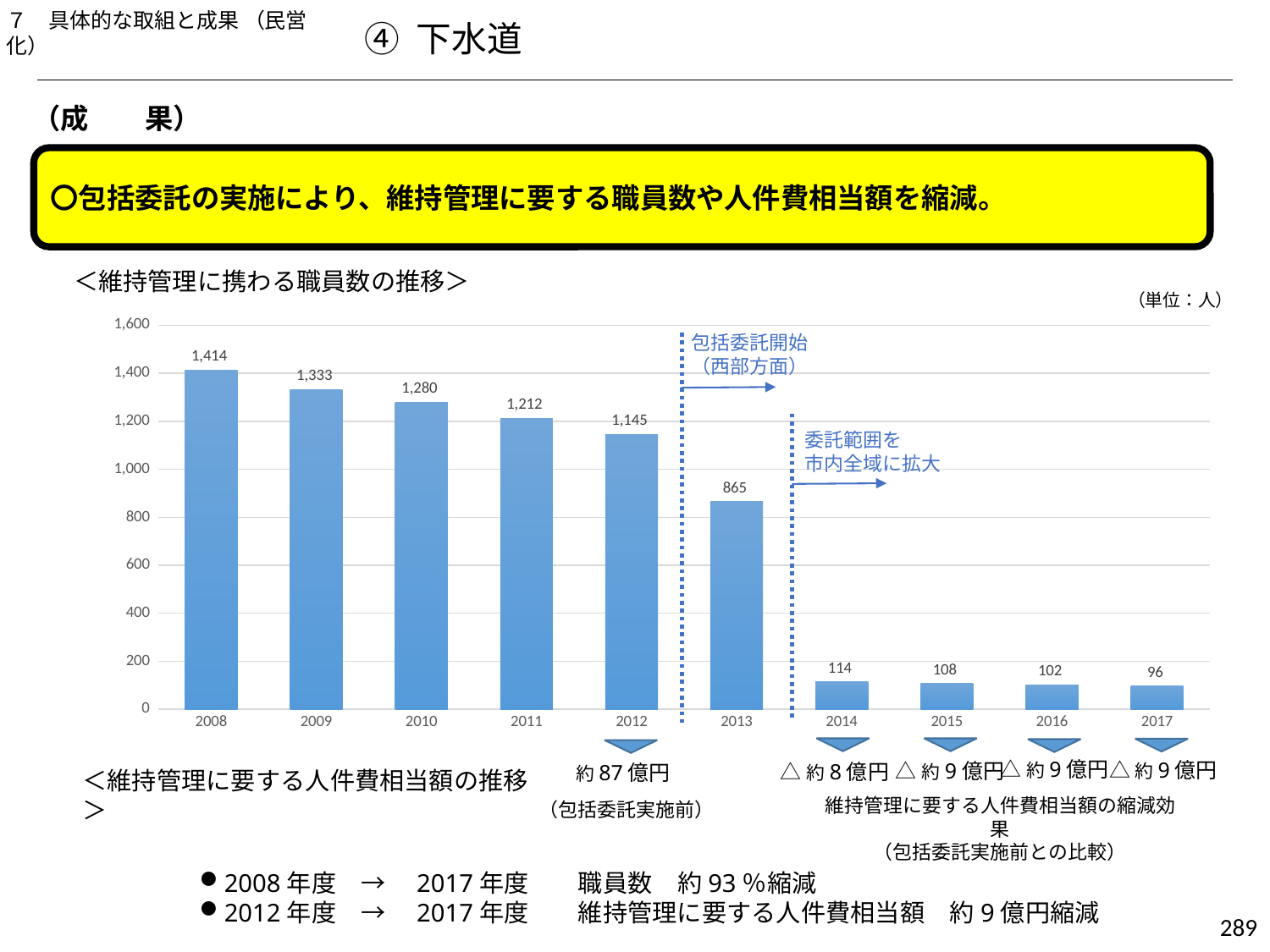
What is the difference between the staff numbers for 2014 and 2017? 18 Which is larger, the value for 2010 or the value for 2011? 2010 What is the number of staff shown for 2008? 1,414 What kind of chart is shown on the slide? bar chart What is the number of staff shown for 2017? 96 Which year has the lowest number of staff? 2017 Is the value for 2013 greater or less than 1,000? less Which year has the highest number of staff? 2008 Do the staff numbers rise or fall from 2008 to 2017? fall What is the number of staff shown for 2013? 865 What is the difference between the staff numbers for 2012 and 2013? 280 How many years are shown on the x axis? 10